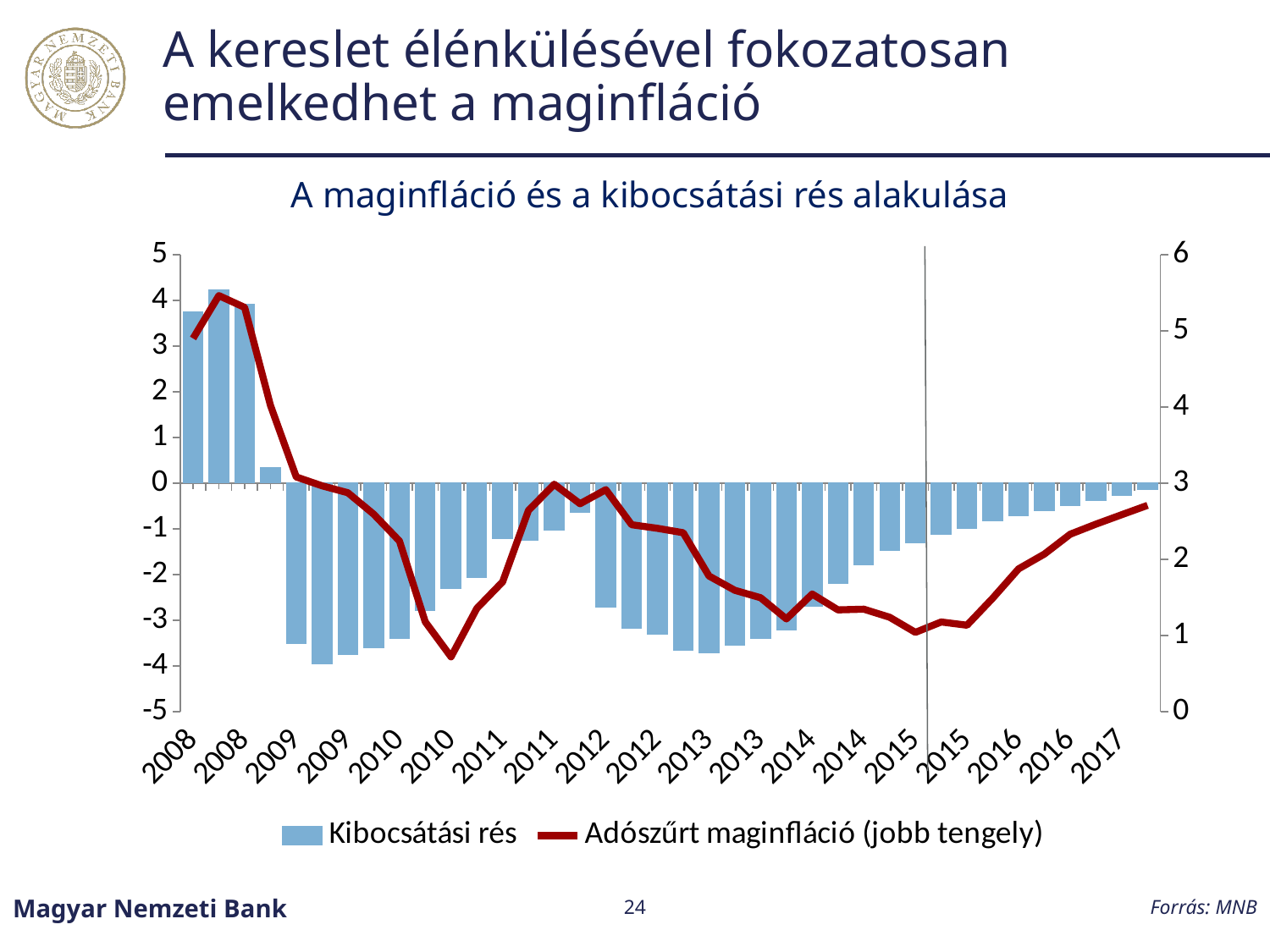
What is the title of the chart? A maginfláció és a kibocsátási rés alakulása In which year does the Kibocsátási rés reach its lowest bar? 2009 Is the final value of the Adószűrt maginfláció line (2017) greater or less than 3 on the right axis? less Which series is plotted on the right axis according to the legend? Adószűrt maginfláció (jobb tengely) What kind of chart is shown on the slide? A combined bar and line chart In which year does the Kibocsátási rés reach its highest bar? 2008 Is the highest point of the Adószűrt maginfláció line greater or less than 5 on the right axis? greater Does the Adószűrt maginfláció line rise or fall between 2008 and 2010? fall Is the value of the first Kibocsátási rés bar (2008) greater or less than 3? greater Does the Adószűrt maginfláció line rise or fall between 2015 and 2017? rise How many series does the legend list? 2